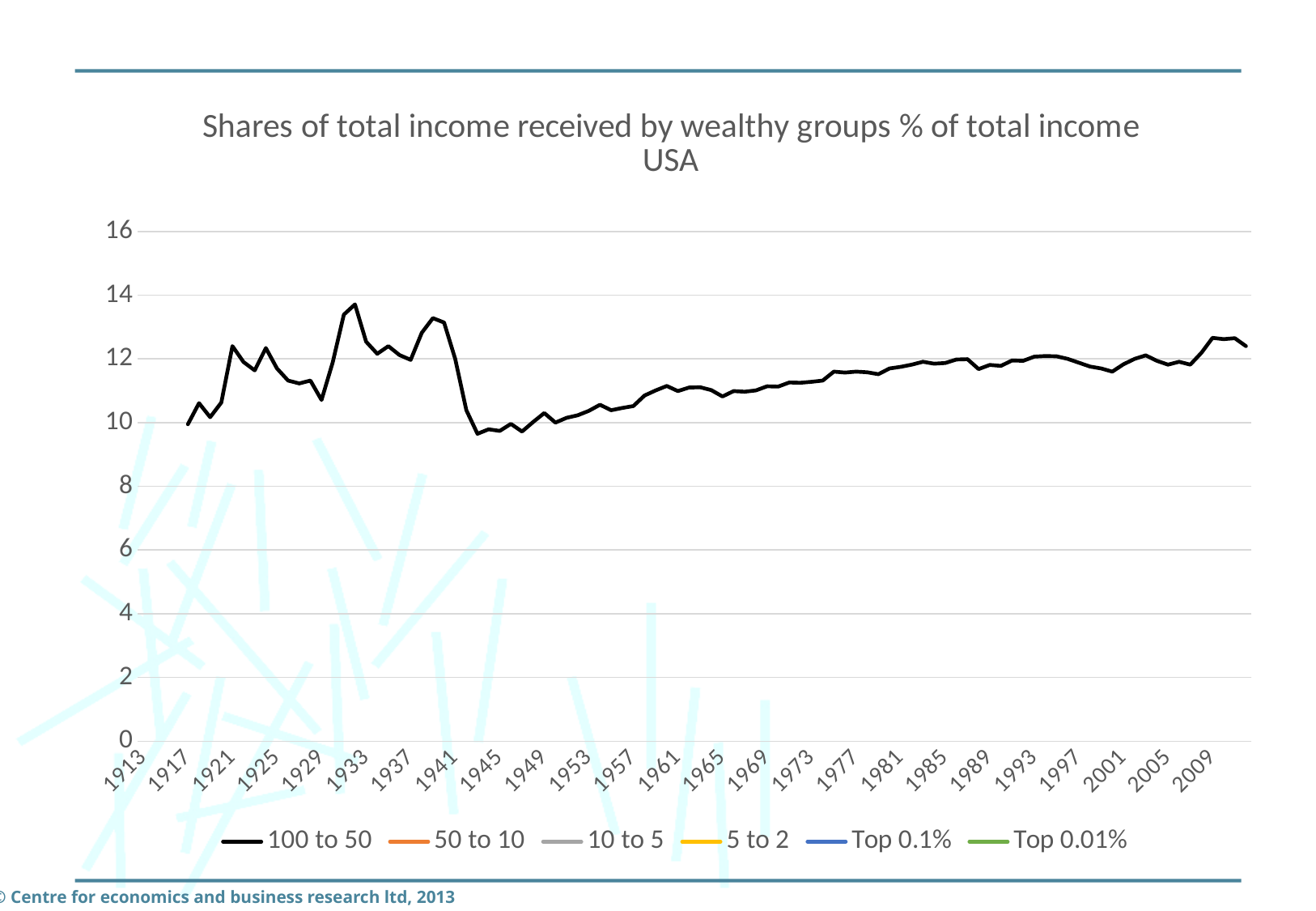
Is the value for the "100 to 50" series in 1965 greater or less than 10? greater What kind of chart is shown on the slide? line chart How many series does the legend list? 6 Is the value for the "100 to 50" series in 1985 greater or less than 14? less Is the value for the "100 to 50" series in 1933 greater or less than 12? greater Does the "100 to 50" series generally rise or fall between 1949 and 1989? rise Is the value for the "100 to 50" series in 1933 larger or smaller than the value in 1949? larger Does the "100 to 50" series rise or fall between 1941 and 1945? fall What is the title of the chart? Shares of total income received by wealthy groups % of total income USA What colour is the line for the "100 to 50" series? black